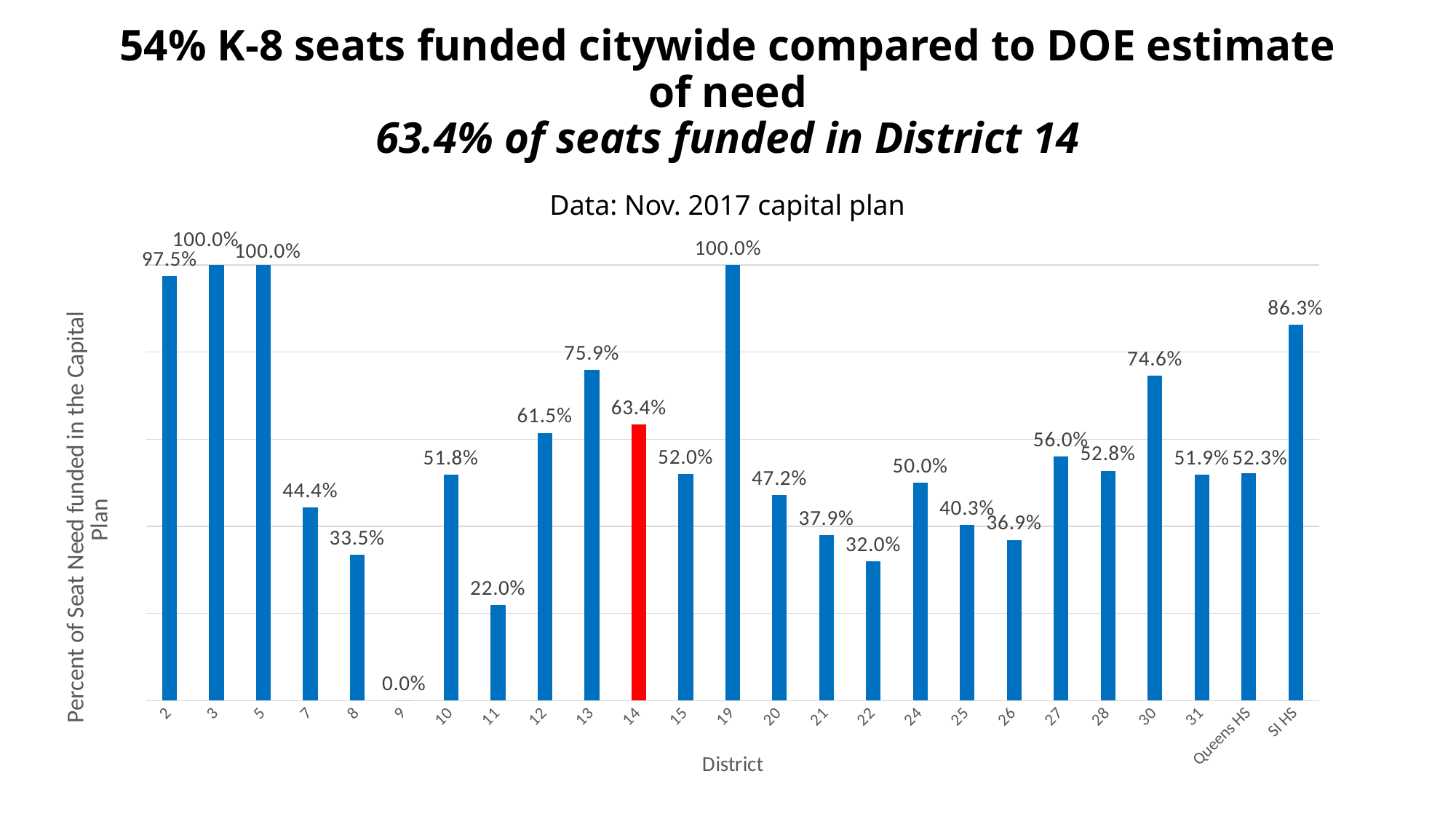
What is the difference between the values for District 13 and District 14? 12.5% How many districts are shown on the x axis? 25 Which is larger, the value for District 27 or the value for District 28? District 27 Which district's bar is coloured red? 14 Which district has the lowest percent of seat need funded? 9 What is the difference between the values for District 2 and District 8? 64.0% What is the value for District 11? 22.0% What kind of chart is shown on the slide? Bar chart What is the value for District 14? 63.4% What is the value for District 30? 74.6% Which is larger, the value for District 21 or the value for District 25? District 25 What is the value for SI HS? 86.3%